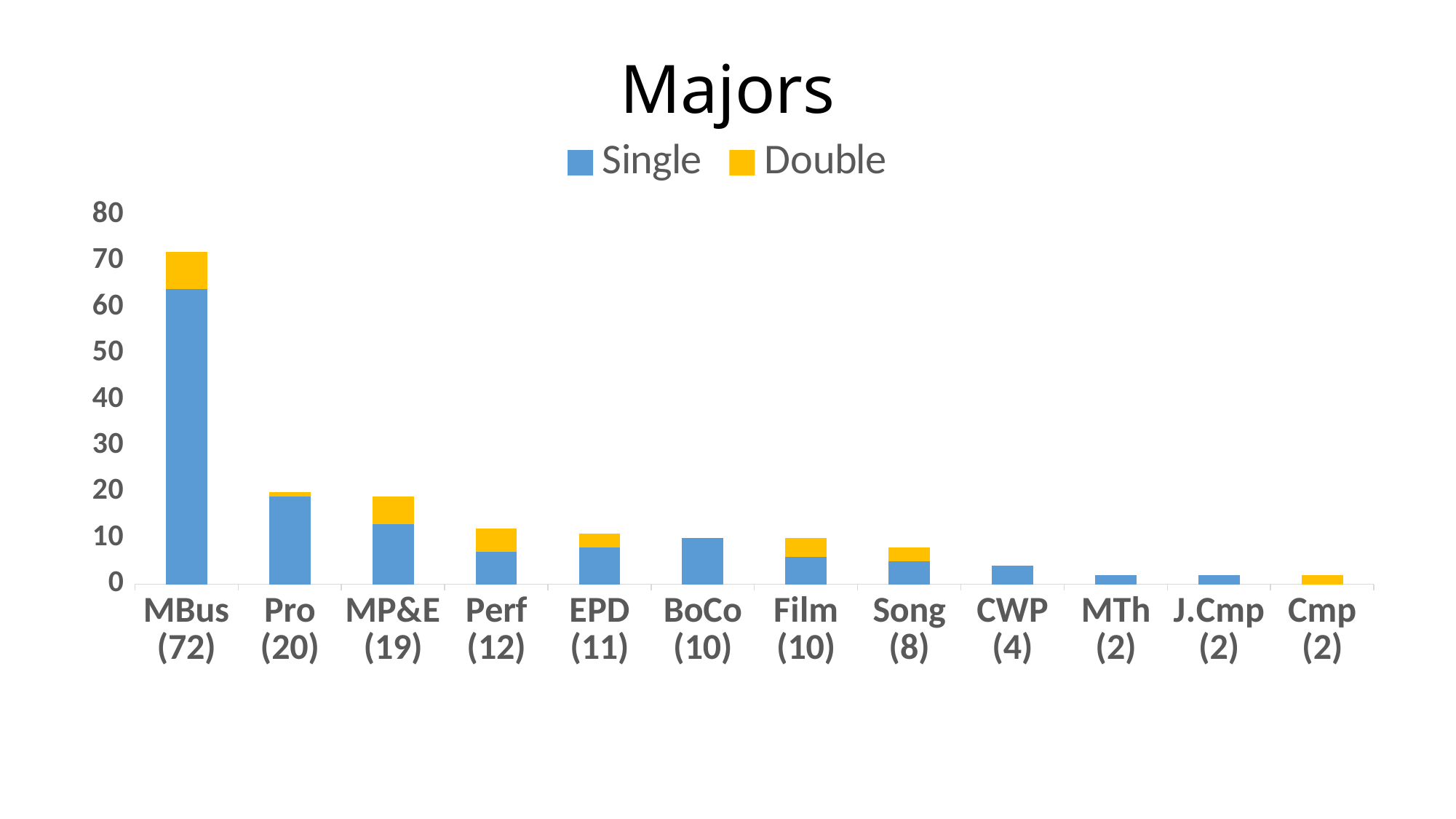
Is the Single value for MBus greater or less than 60? greater Do the totals rise or fall from left to right along the x axis? fall Which has a larger total, Perf or CWP? Perf What is the difference between the totals for MBus and Pro? 52 What kind of chart is shown on the slide? stacked bar chart What is the total shown for Song? 8 How many series does the legend list? 2 Which category has the highest total? MBus What is the total shown for MP&E? 19 Is the Single value for Film greater or less than 10? less How many categories are shown on the x axis? 12 What is the title of the chart? Majors